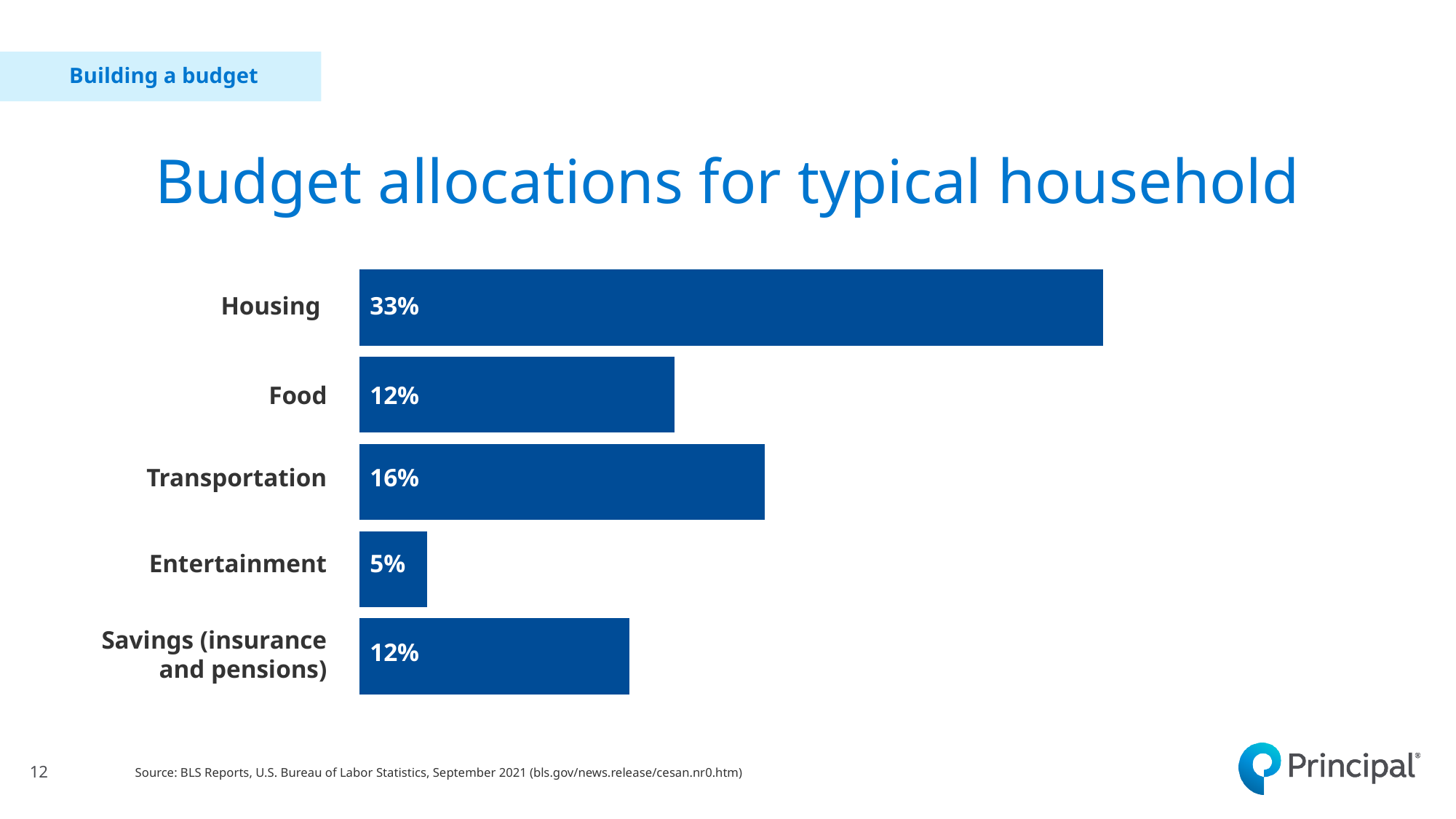
What is the value for Housing? 33% What is the difference between the values for Housing and Food? 21% What is the title of the chart? Budget allocations for typical household What kind of chart is shown on the slide? Bar chart Which category has the lowest value? Entertainment Which is larger, the value for Transportation or the value for Food? Transportation Which category has the highest value? Housing How many categories are shown in the chart? 5 What is the value for Savings (insurance and pensions)? 12% What is the value for Transportation? 16% What is the difference between the values for Transportation and Entertainment? 11% What is the value for Entertainment? 5%